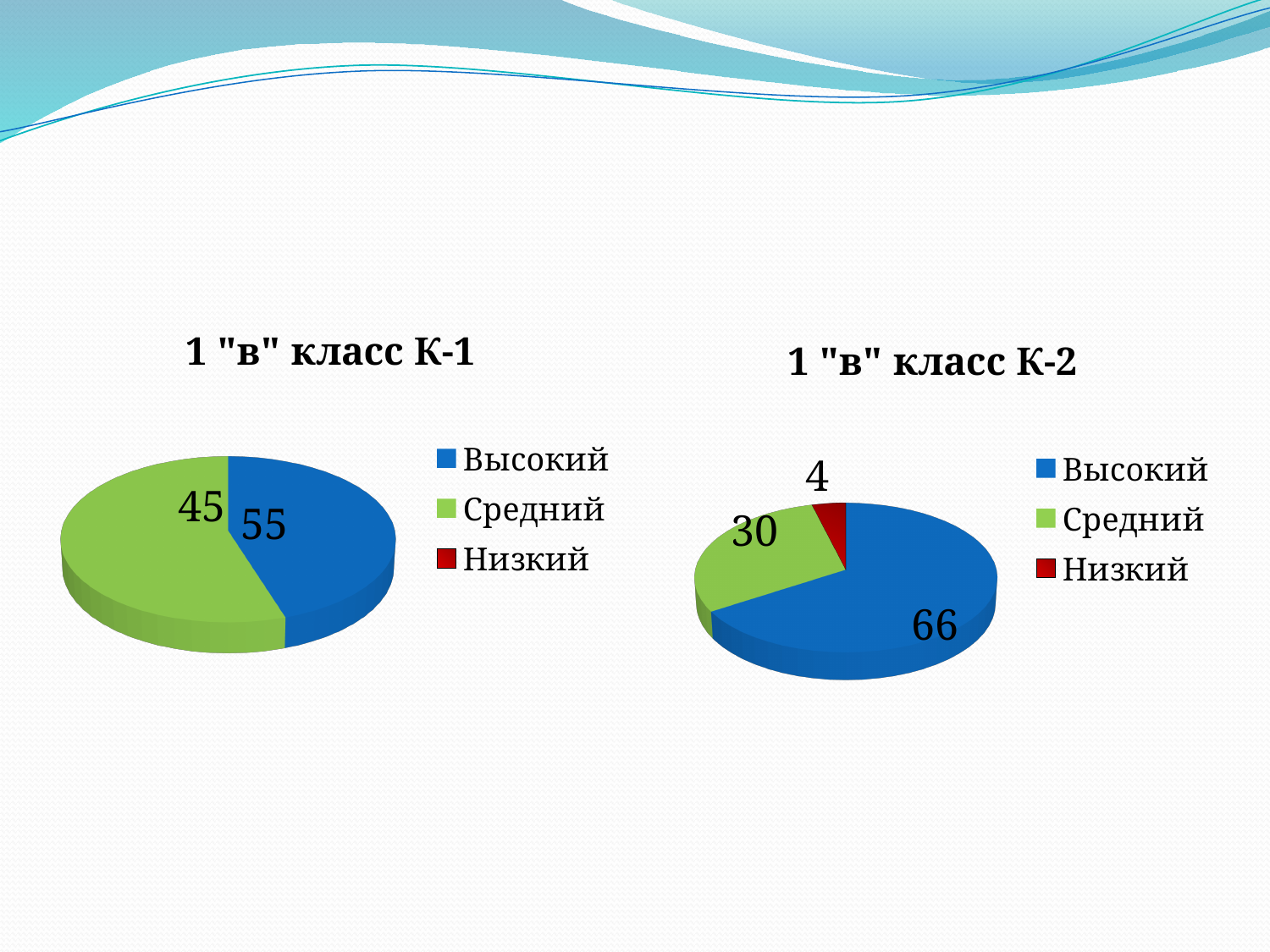
In the chart titled 1 "в" класс К-1, which is larger, Высокий or Средний? Средний In the chart titled 1 "в" класс К-1, what is the difference between the values for Высокий and Средний? 10 In the chart titled 1 "в" класс К-2, what is the value for Высокий? 66 In the chart titled 1 "в" класс К-2, what is the difference between the values for Высокий and Средний? 36 What type of chart is the chart titled 1 "в" класс К-2? Pie chart How many slices does the pie in the chart titled 1 "в" класс К-2 have? 3 In the chart titled 1 "в" класс К-2, which category has the largest slice? Высокий In the chart titled 1 "в" класс К-2, which category has the smallest slice? Низкий How many entries does the legend of the chart titled 1 "в" класс К-1 list? 3 In the chart titled 1 "в" класс К-2, what is the value for Низкий? 4